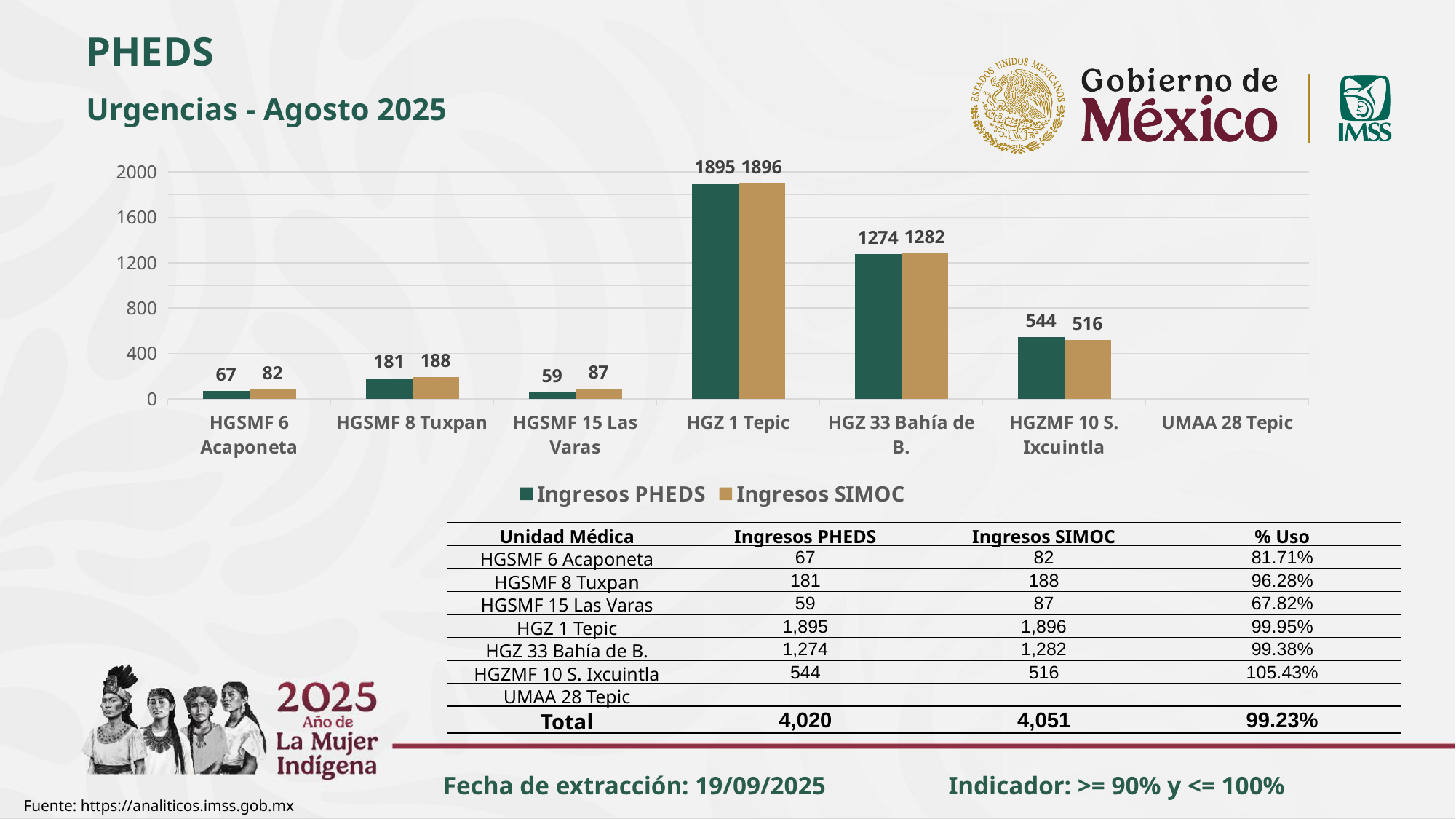
What is the Ingresos SIMOC value for HGSMF 15 Las Varas in the chart? 87 Is the Ingresos PHEDS value for HGZ 33 Bahía de B. greater or less than 1200? greater What is the difference between the Ingresos SIMOC and Ingresos PHEDS values for HGSMF 6 Acaponeta? 15 What is the Ingresos PHEDS value for HGZ 1 Tepic in the chart? 1895 What is the Ingresos PHEDS value for HGZMF 10 S. Ixcuintla in the chart? 544 Among the categories with bars, which has the lowest Ingresos PHEDS value? HGSMF 15 Las Varas Which category has the highest Ingresos SIMOC value in the chart? HGZ 1 Tepic What kind of chart is shown on the slide? Bar chart How many categories are shown on the x axis of the chart? 7 For HGZMF 10 S. Ixcuintla, which is larger: Ingresos PHEDS or Ingresos SIMOC? Ingresos PHEDS What are the two series named in the chart legend? Ingresos PHEDS and Ingresos SIMOC How many series does the chart legend list? 2